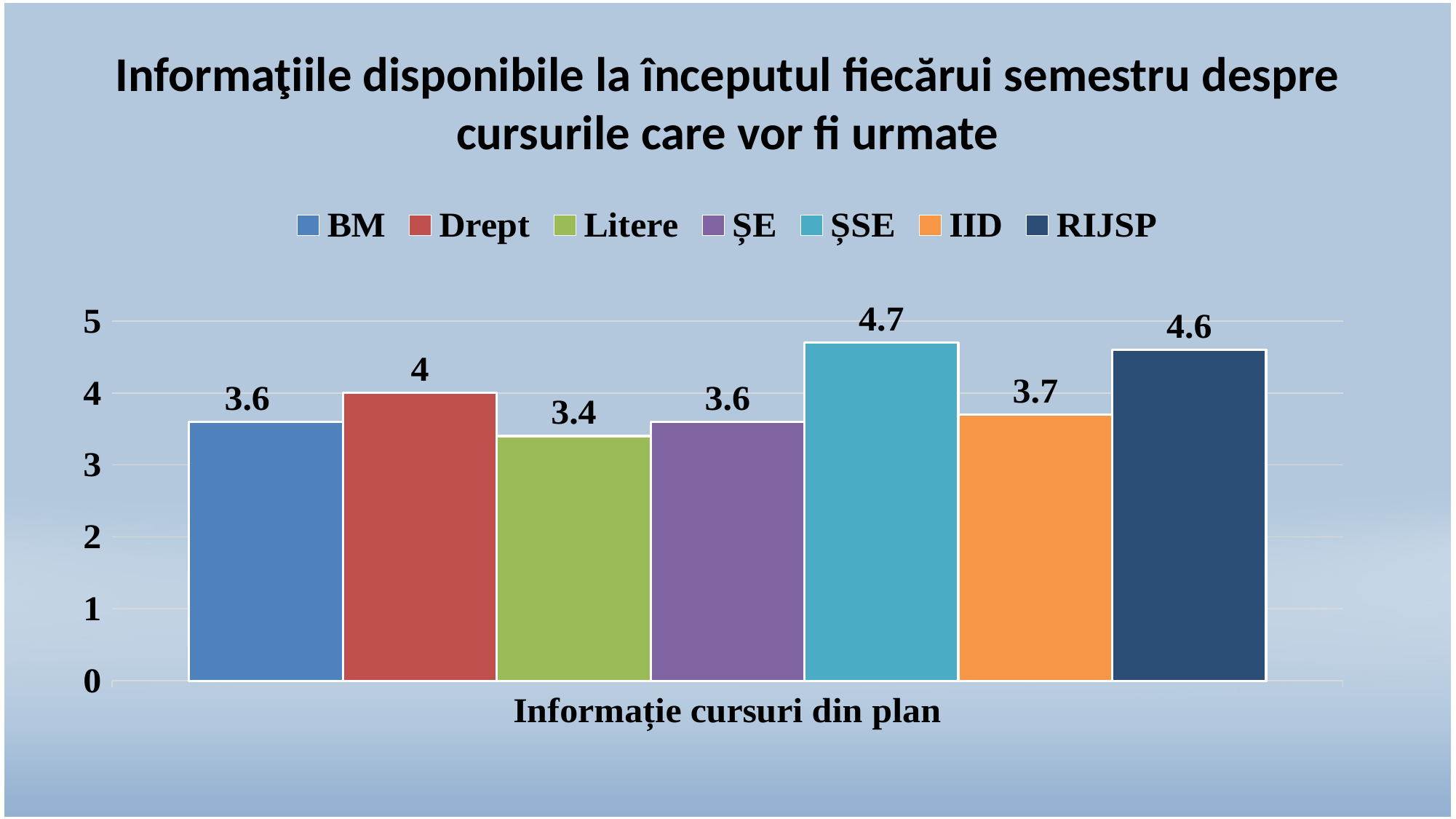
What is the label on the x axis of the chart? Informație cursuri din plan How many series does the legend list? 7 What is the value for Litere? 3.4 What is the value for IID? 3.7 What is the value for Drept? 4 Which is larger, the value for RIJSP or the value for IID? RIJSP What is the difference between the values for RIJSP and Drept? 0.6 What is the difference between the values for ȘSE and Litere? 1.3 What kind of chart is shown on the slide? Bar chart Which series has the lowest value? Litere Which series has the highest value? ȘSE What is the value for ȘSE? 4.7